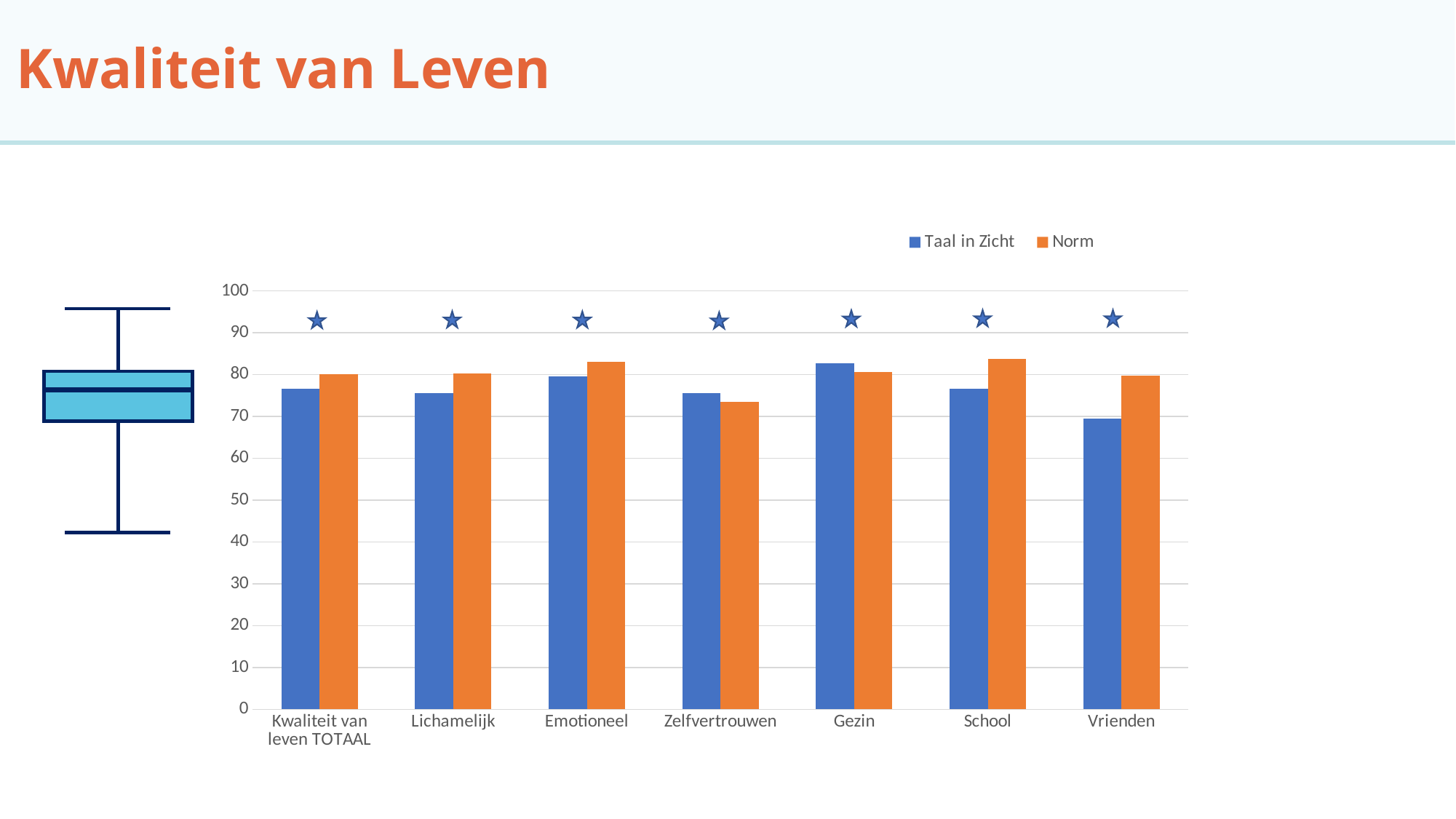
Is the Taal in Zicht value for Gezin greater or less than 80? greater How many series does the chart's legend list? 2 For Vrienden, which is larger: Taal in Zicht or Norm? Norm Which category has the lowest value for Taal in Zicht? Vrienden Which category has the lowest value for Norm? Zelfvertrouwen Which category has the highest value for Taal in Zicht? Gezin How many categories are shown on the x axis of the chart? 7 Is the Norm value for Zelfvertrouwen greater or less than 80? less Is the Taal in Zicht value for Lichamelijk greater or less than 70? greater What are the two series named in the chart's legend? Taal in Zicht and Norm What kind of chart is shown on the slide? bar chart For Zelfvertrouwen, which is larger: Taal in Zicht or Norm? Taal in Zicht